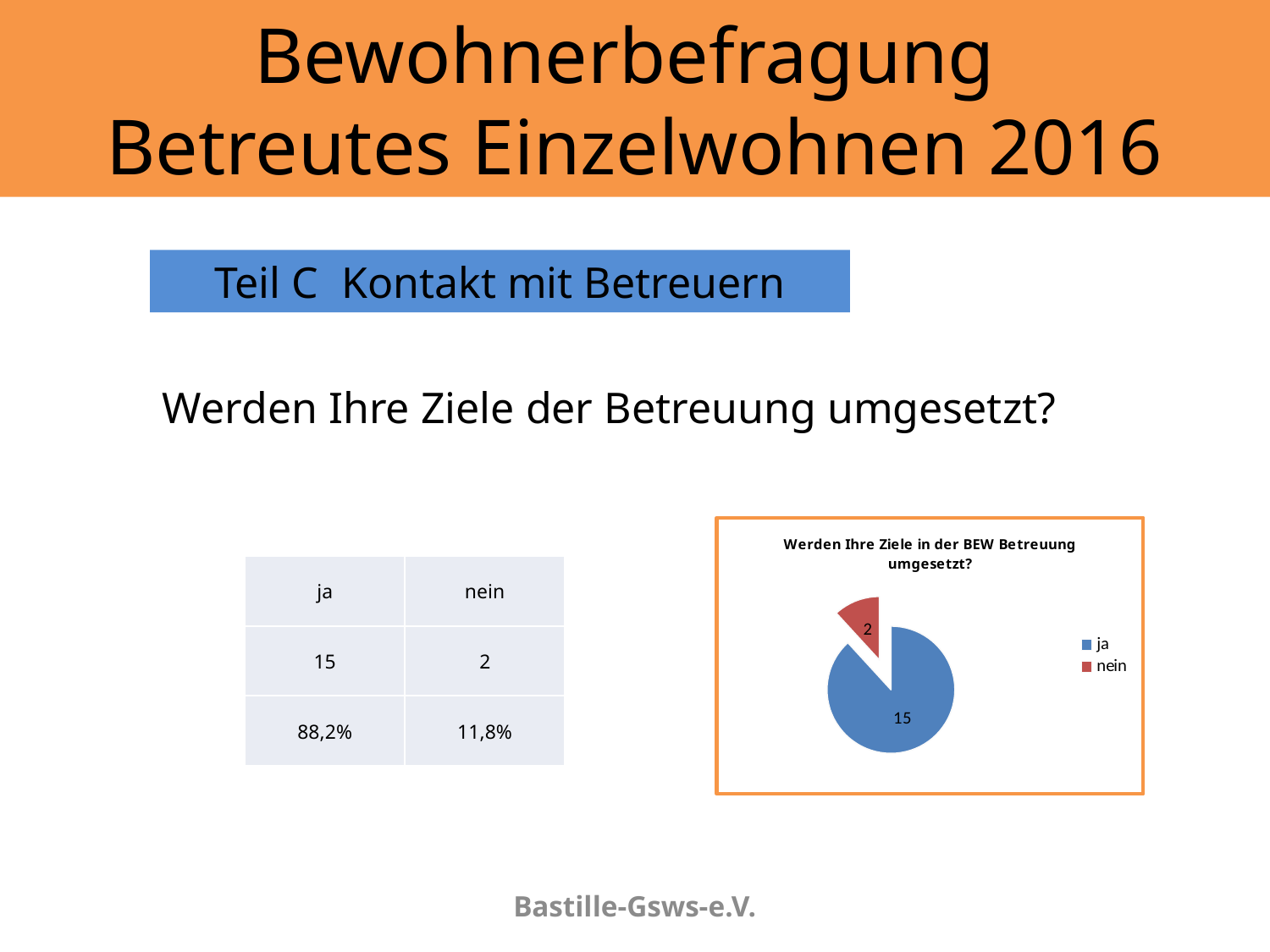
What is the difference between the "ja" and "nein" values in the pie chart? 13 How many slices does the pie chart have? 2 What is the title of the pie chart? Werden Ihre Ziele in der BEW Betreuung umgesetzt? How many entries does the pie chart's legend list? 2 What type of chart is shown on the slide? pie chart What is the total of all slices in the pie chart? 17 Which slice of the pie chart is the largest? ja What share of the pie does the "ja" slice represent? 88,2% Which is larger in the pie chart, "ja" or "nein"? ja Which slice of the pie chart is the smallest? nein What is the value of the "nein" slice in the pie chart? 2 What is the value of the "ja" slice in the pie chart? 15